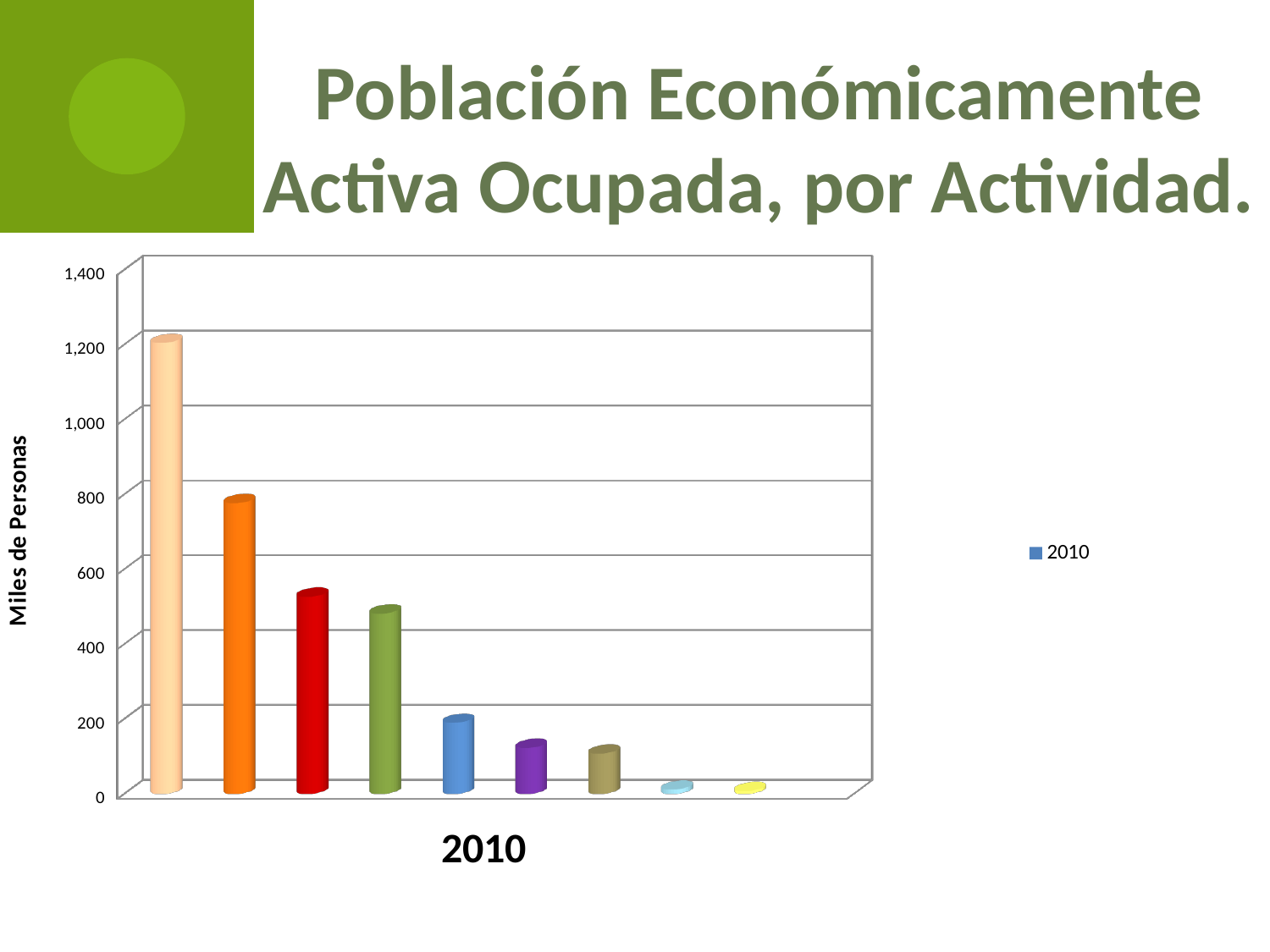
Is the value of the leftmost (peach) bar greater or less than 1,000? greater How many series does the legend list? 1 Is the value of the green bar greater or less than 600? less Which is larger, the orange bar or the red bar? the orange bar Which bar is the tallest in the chart? the leftmost (peach) bar How many bars are plotted in the chart? 9 Which bar is the shortest in the chart? the rightmost (yellow) bar What kind of chart is shown on the slide? bar chart Is the value of the purple bar greater or less than 200? less What is the title of the vertical axis? Miles de Personas Do the bar values rise or fall from left to right across the chart? fall